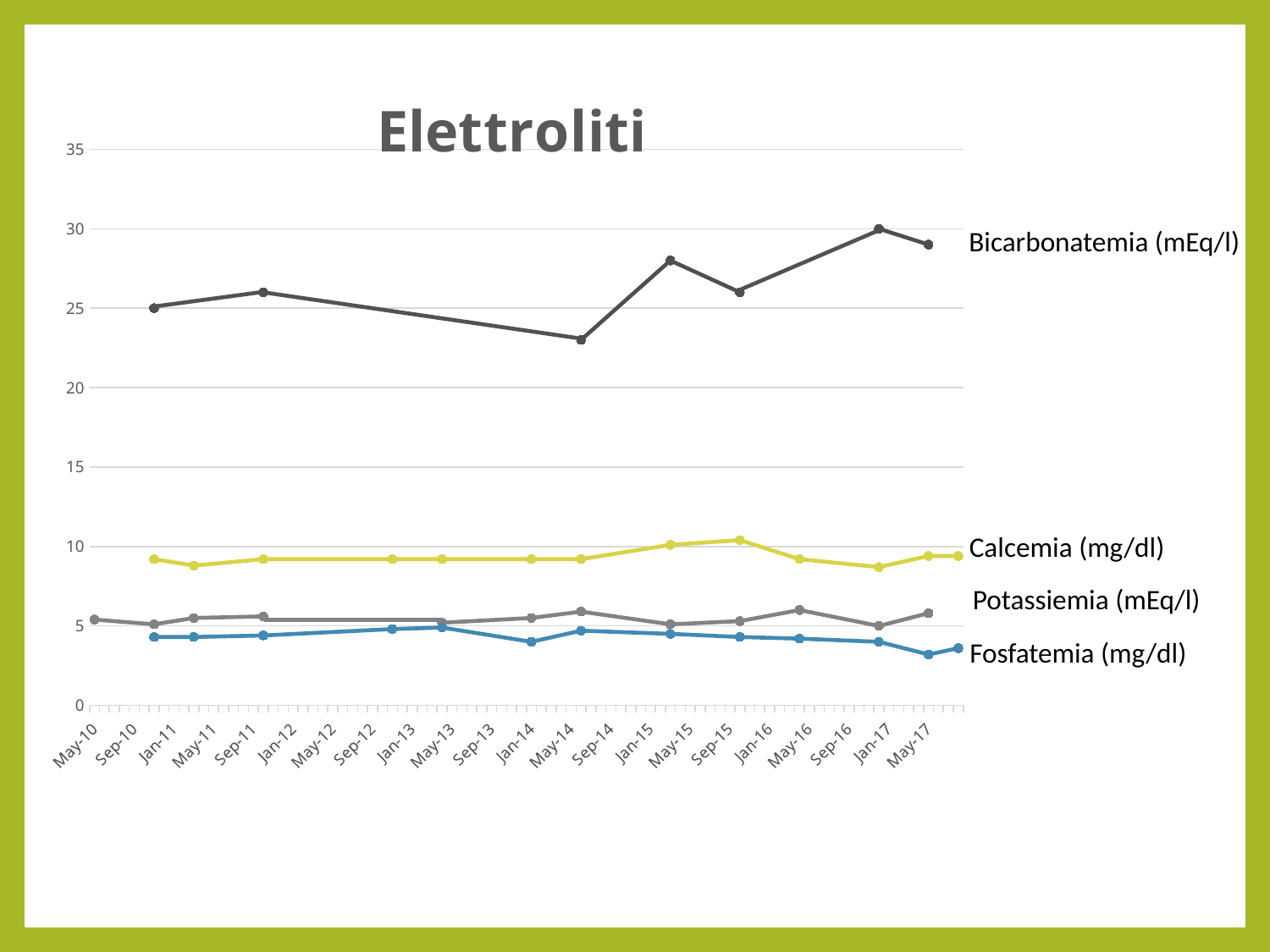
Which series has the lowest values throughout the chart? Fosfatemia (mg/dl) What is the title of the chart? Elettroliti What kind of chart is shown on the slide? line chart How many series are plotted on the chart? 4 Does Bicarbonatemia (mEq/l) rise or fall between Jan-14 and Jan-17? rise Is the value of Bicarbonatemia (mEq/l) at Jan-14 greater or less than 25? less Which series has larger values, Calcemia (mg/dl) or Potassiemia (mEq/l)? Calcemia (mg/dl) Is the value of Potassiemia (mEq/l) at May-16 greater or less than 10? less Is the value of Calcemia (mg/dl) at Sep-15 greater or less than 10? greater Which series has the highest values throughout the chart? Bicarbonatemia (mEq/l)